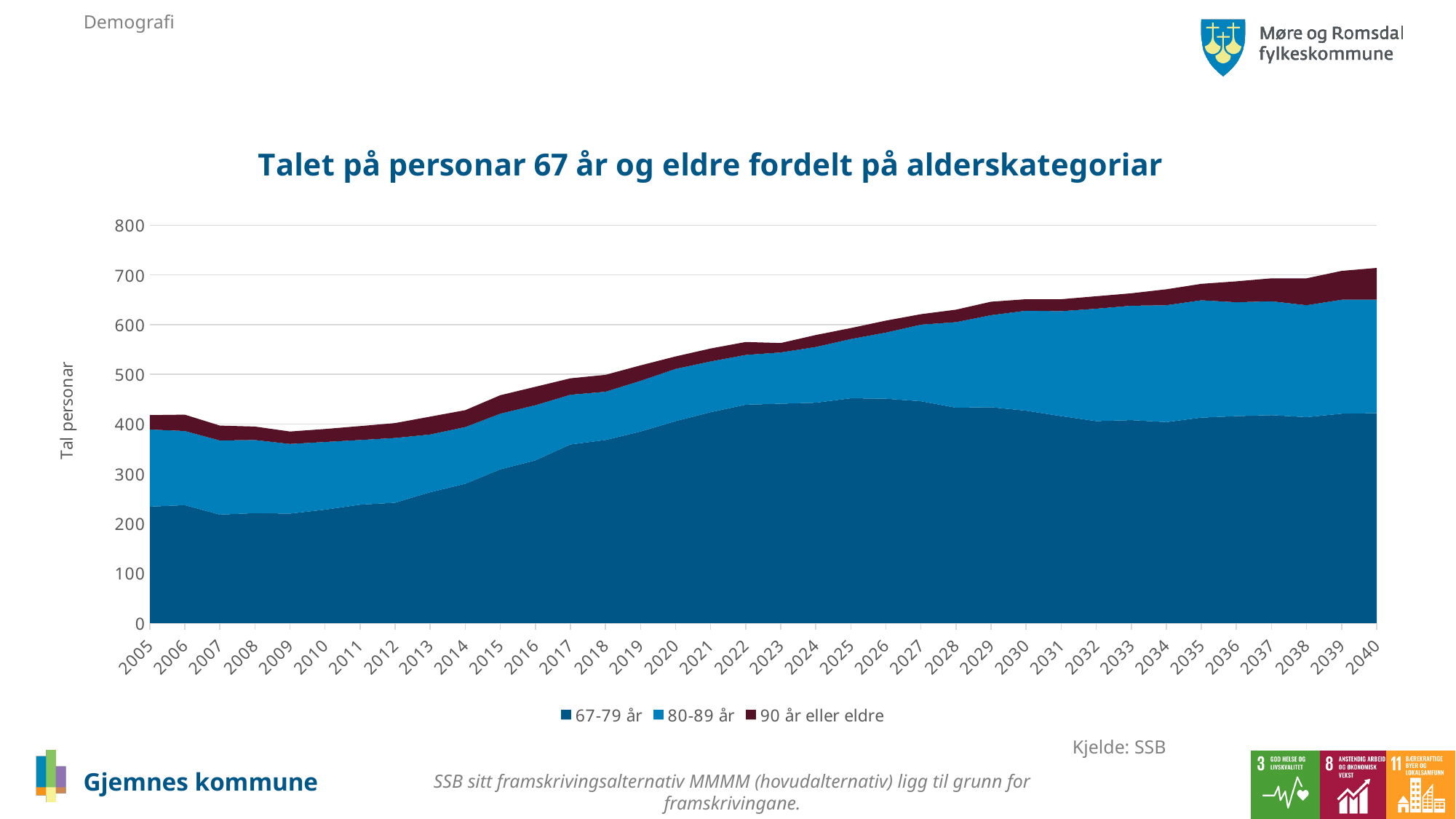
Is the total number of persons 67 år og eldre in 2040 greater or less than 700? greater Which age category has the largest number of persons in 2040? 67-79 år Is the value for 67-79 år in 2005 greater or less than 200? greater What is the label on the vertical axis? Tal personar What is the title of the chart? Talet på personar 67 år og eldre fordelt på alderskategoriar Which age category has the smallest number of persons in 2040? 90 år eller eldre How many series does the legend list? 3 Is the value for 67-79 år in 2025 greater or less than 400? greater How many years are shown along the x axis? 36 Does the total number of persons 67 år og eldre rise or fall from 2005 to 2040? rise What kind of chart is shown on the slide? Stacked area chart